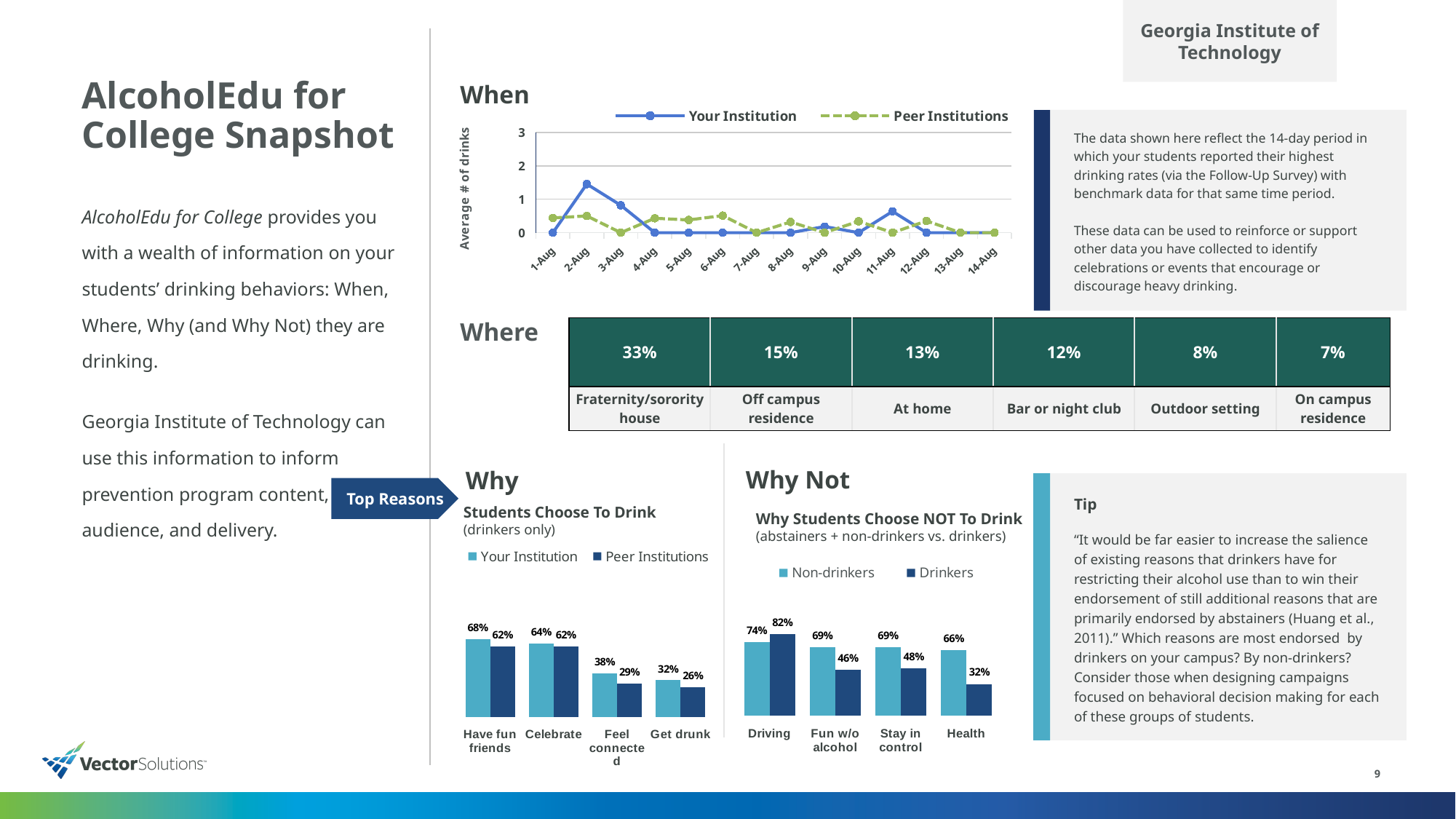
In the 'Students Choose To Drink' chart, what is the Peer Institutions value for 'Feel connected'? 29% How many dates are plotted on the x axis of the 'When' line chart? 14 In the 'When' line chart, is the Your Institution value on 2-Aug greater or less than 1? greater In the 'Why Students Choose NOT To Drink' chart, what is the difference between Non-drinkers and Drinkers for 'Health'? 34% In the 'Why Students Choose NOT To Drink' chart, which is larger for 'Driving': Non-drinkers or Drinkers? Drinkers How many series does the legend of the 'When' chart list? 2 In the 'Why Students Choose NOT To Drink' chart, what is the Drinkers value for 'Driving'? 82% In the 'Why Students Choose NOT To Drink' chart, what is the Non-drinkers value for 'Health'? 66% In the 'Students Choose To Drink' chart, what is the value for Your Institution for 'Have fun friends'? 68% In the 'Students Choose To Drink' chart, which category has the lowest Your Institution value? Get drunk In the 'Students Choose To Drink' chart, what is the difference between Your Institution and Peer Institutions for 'Get drunk'? 6% In the 'Why Students Choose NOT To Drink' chart, which category has the lowest Drinkers value? Health